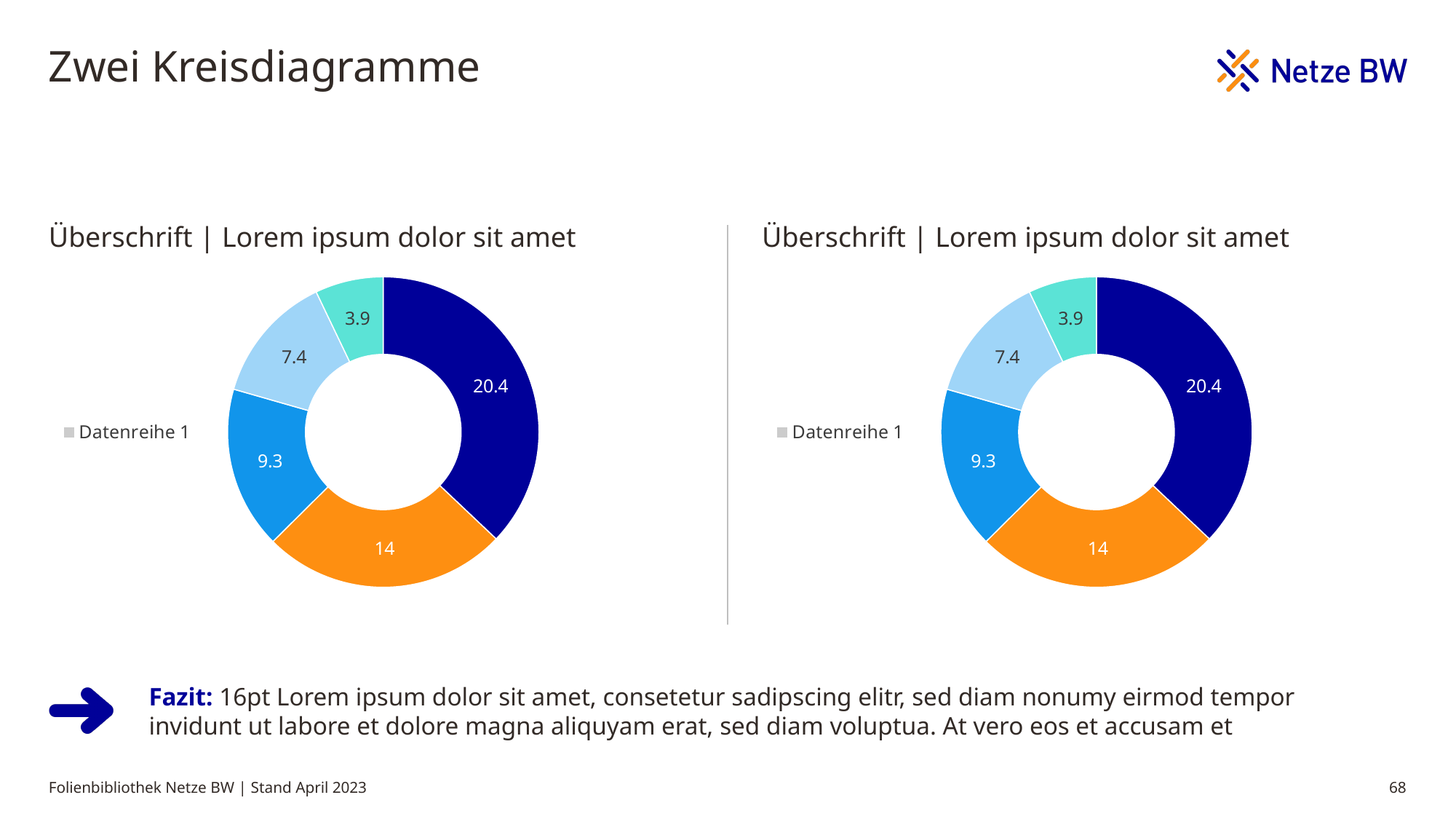
What is the largest value shown in the left chart? 20.4 How many series does the legend of the right chart list? 1 In the left chart, what is the difference between the largest slice (20.4) and the orange slice (14)? 6.4 In the right chart, which is larger: the orange slice or the light blue slice? The orange slice (14) What kind of chart is the left chart on the slide? Doughnut (pie) chart What is the legend entry shown next to the left chart? Datenreihe 1 How many slices does the left chart have? 5 In the right chart, what is the value of the dark blue slice? 20.4 In the left chart, what is the value of the orange slice? 14 What is the total of all slice values in the left chart? 55 What is the smallest value shown in the right chart? 3.9 Do the left and right charts show the same values? Yes